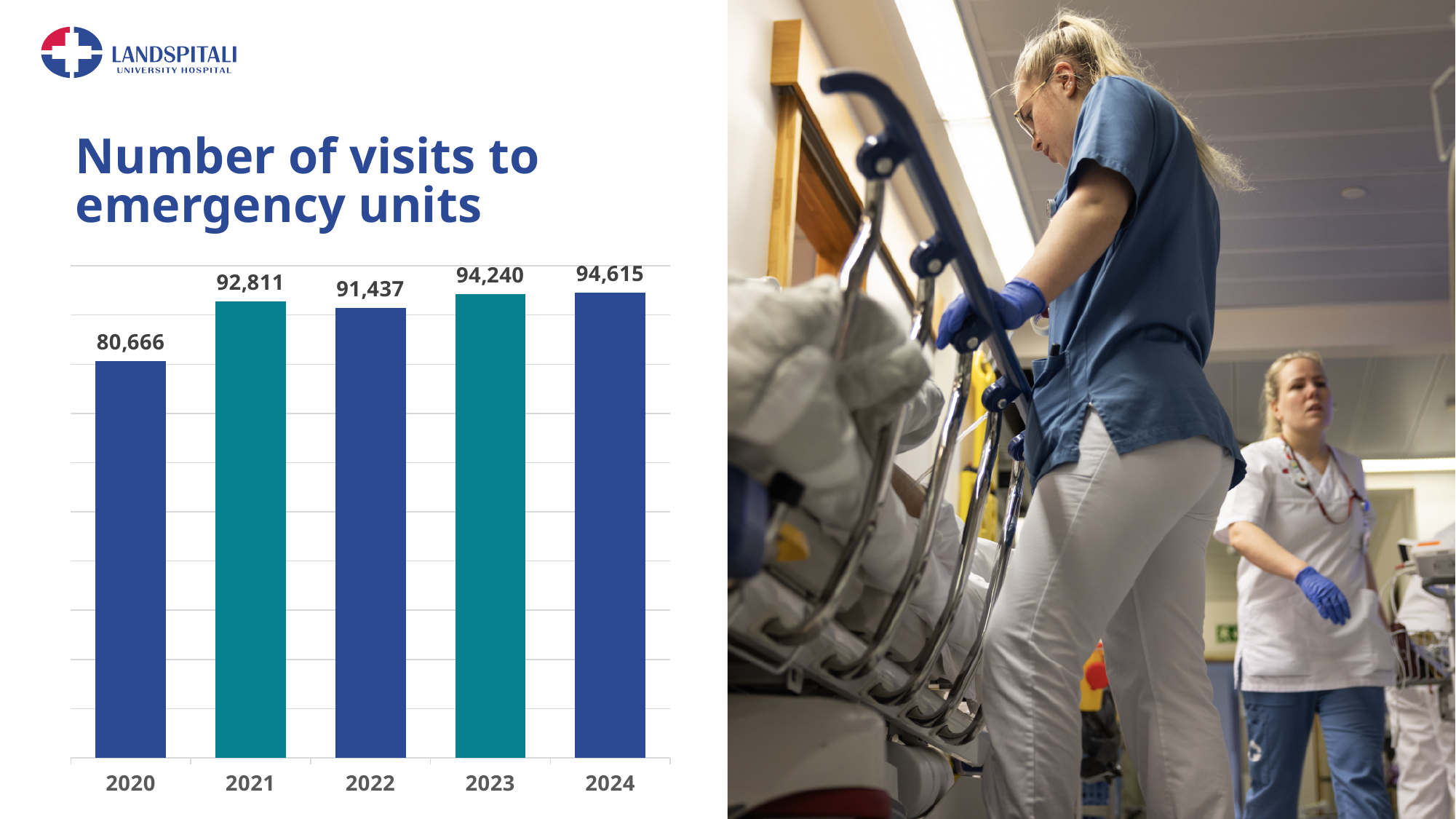
How many years are shown in the chart? 5 Which year had more visits to emergency units, 2021 or 2022? 2021 What was the number of visits to emergency units in 2022? 91,437 Which year had the lowest number of visits to emergency units? 2020 What was the number of visits to emergency units in 2020? 80,666 What was the number of visits to emergency units in 2024? 94,615 What is the difference in visits to emergency units between 2021 and 2022? 1,374 Which year had the highest number of visits to emergency units? 2024 How many more visits to emergency units were there in 2024 than in 2020? 13,949 What is the title of the chart? Number of visits to emergency units Overall, did the number of visits to emergency units rise or fall from 2020 to 2024? Rise What kind of chart is shown on the slide? Bar chart